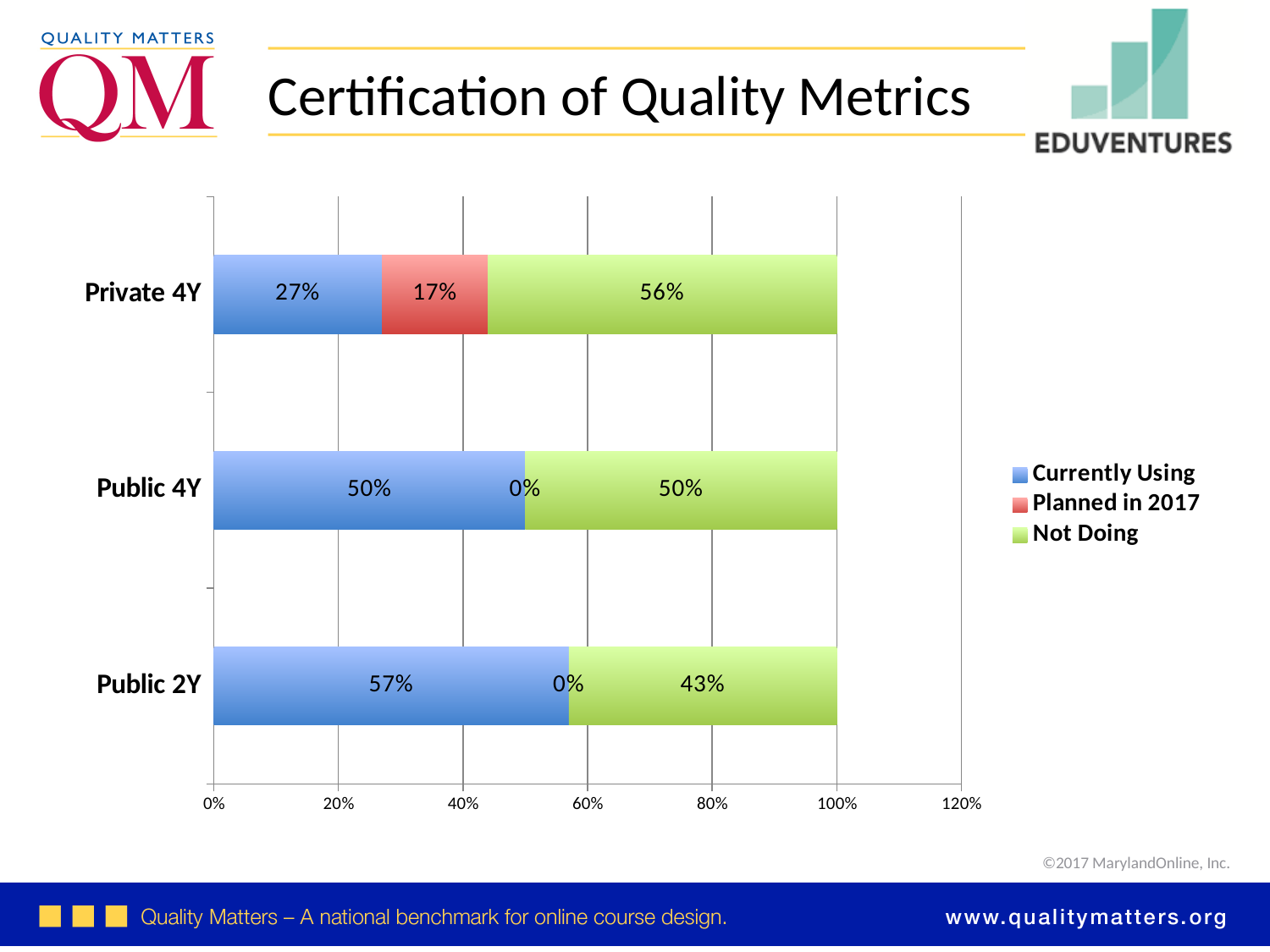
Which category has the lowest Currently Using value? Private 4Y What is the Currently Using value for Public 4Y? 50% Which is larger: the Not Doing value for Private 4Y or for Public 4Y? Private 4Y What is the difference between the Currently Using values for Public 2Y and Private 4Y? 30% How many categories are shown on the chart? 3 Which category has the highest Currently Using value? Public 2Y What is the Not Doing value for Public 2Y? 43% What kind of chart is shown on the slide? Stacked bar chart What percentage of Private 4Y institutions are Currently Using certification of quality metrics? 27% How many series does the legend list? 3 What is the Planned in 2017 value for Private 4Y? 17% What is the title of the slide? Certification of Quality Metrics